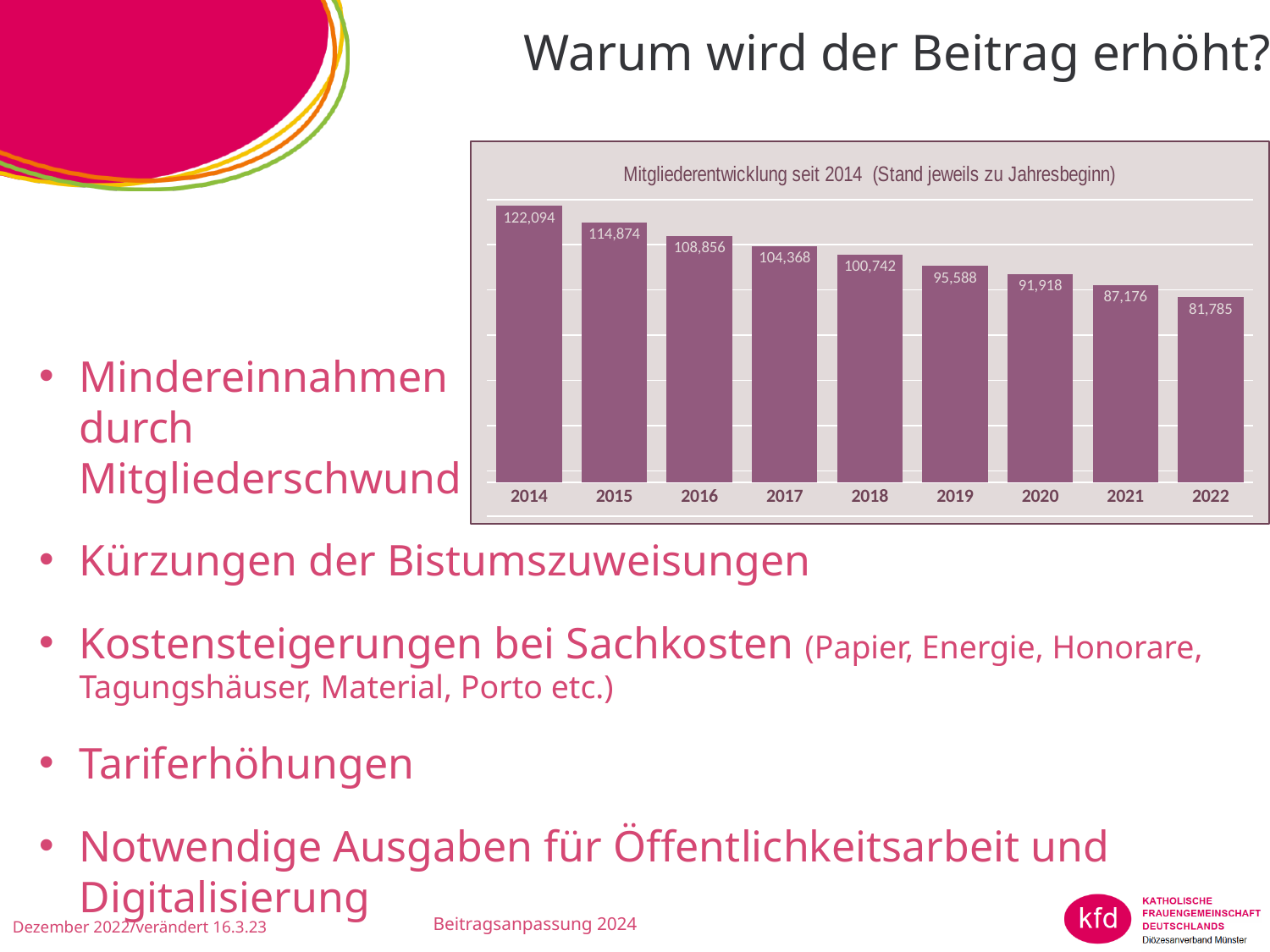
What is the difference between the values for 2019 and 2020? 3,670 What is the value shown for 2022? 81,785 What is the value shown for 2014? 122,094 How many years are shown on the x axis? 9 Which is larger, the value for 2016 or the value for 2017? 2016 Which year has the highest value? 2014 What is the value shown for 2018? 100,742 What is the title of the chart? Mitgliederentwicklung seit 2014 (Stand jeweils zu Jahresbeginn) What type of chart is shown on the slide? Bar chart Do the values rise or fall from 2014 to 2022? Fall Which year has the lowest value? 2022 What is the difference between the values for 2014 and 2022? 40,309